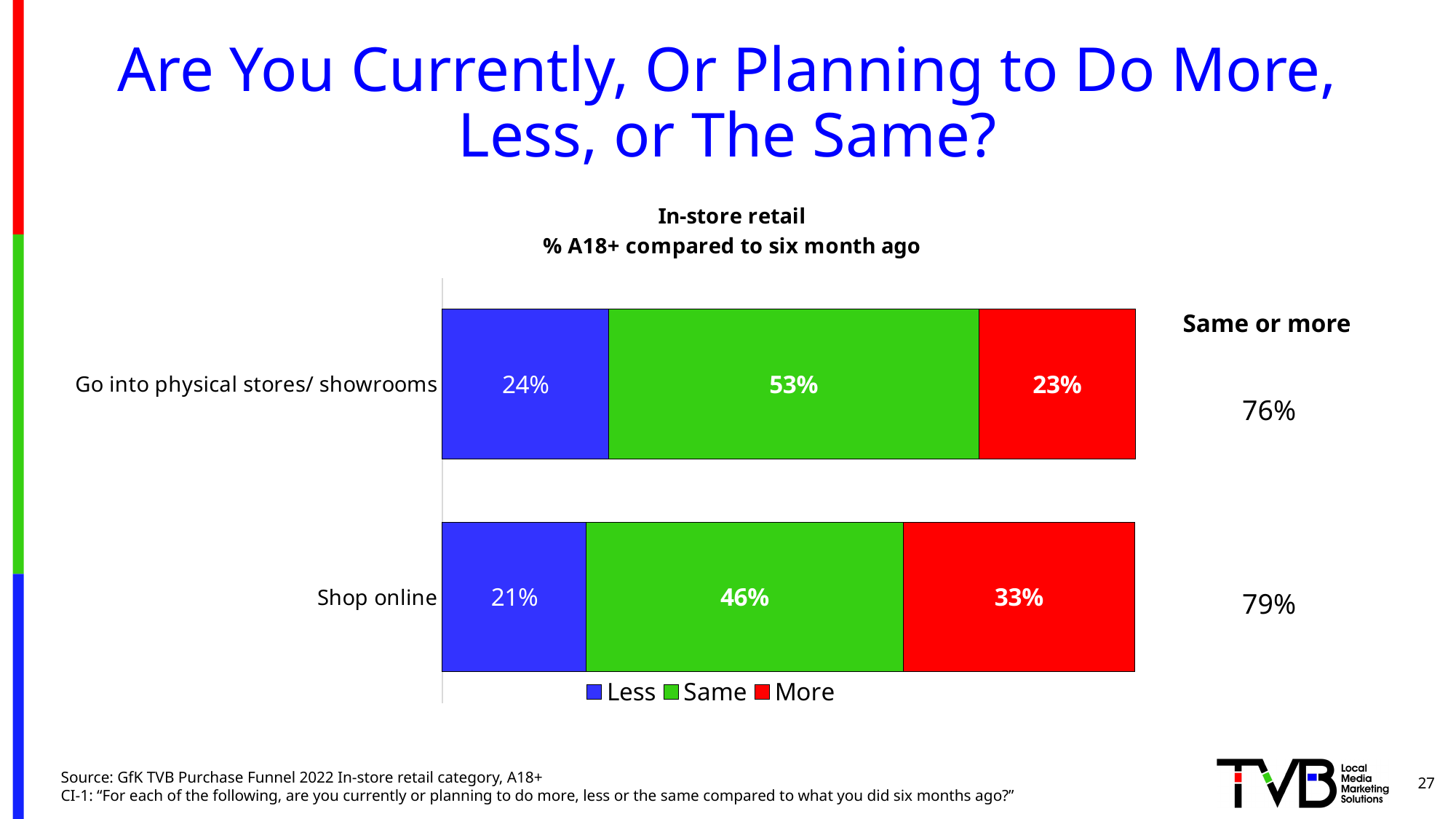
Which category has the larger 'More' share: Go into physical stores/showrooms or Shop online? Shop online What percentage of respondents say they will do the same amount of going into physical stores/showrooms? 53% What is the difference between the 'More' percentages for Shop online and Go into physical stores/showrooms? 10% How many series does the legend list? 3 What percentage of respondents say they will go into physical stores/showrooms less? 24% What is the 'Same or more' figure shown for Shop online? 79% What is the difference between the 'Same' percentages for Go into physical stores/showrooms and Shop online? 7% What percentage of respondents say they will shop online more? 33% What is the total of the three segments in the Shop online bar? 100% What kind of chart is shown on the slide? Stacked bar chart How many categories are shown in the chart? 2 Which colour represents the 'More' series in the chart? Red